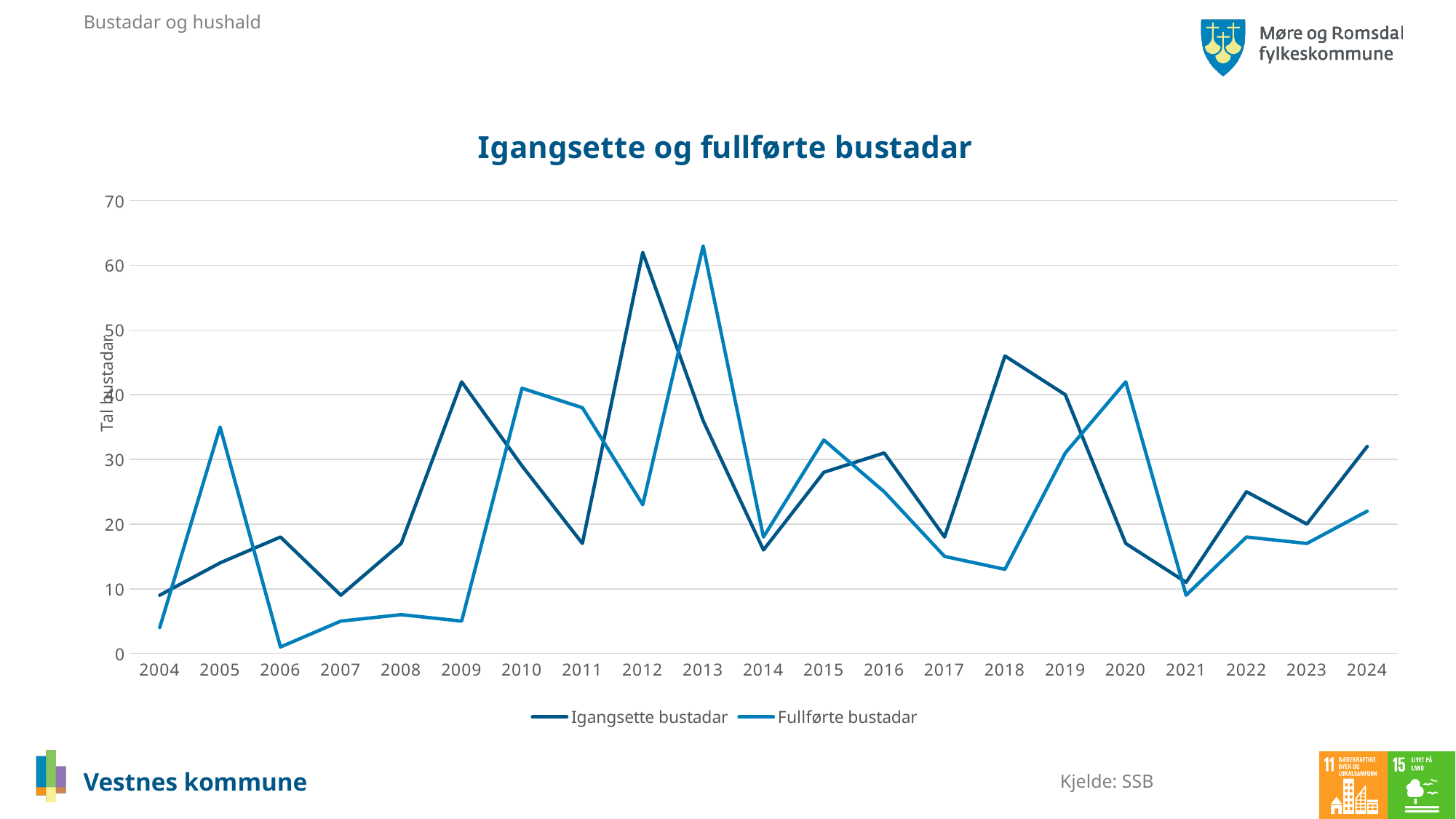
How many years are plotted along the x axis? 21 How many series does the legend list? 2 Is the value for Igangsette bustadar in 2012 greater or less than 50? greater In which year does the Fullførte bustadar series reach its lowest value? 2006 What is the title of the chart? Igangsette og fullførte bustadar In 2005, which series has the larger value, Igangsette bustadar or Fullførte bustadar? Fullførte bustadar In which year does the Fullførte bustadar series reach its highest value? 2013 What kind of chart is shown on the slide? line chart Does the Igangsette bustadar series rise or fall from 2018 to 2021? fall Is the value for Fullførte bustadar in 2006 greater or less than 10? less In which year does the Igangsette bustadar series reach its highest value? 2012 Is the value for Igangsette bustadar in 2018 greater or less than 40? greater